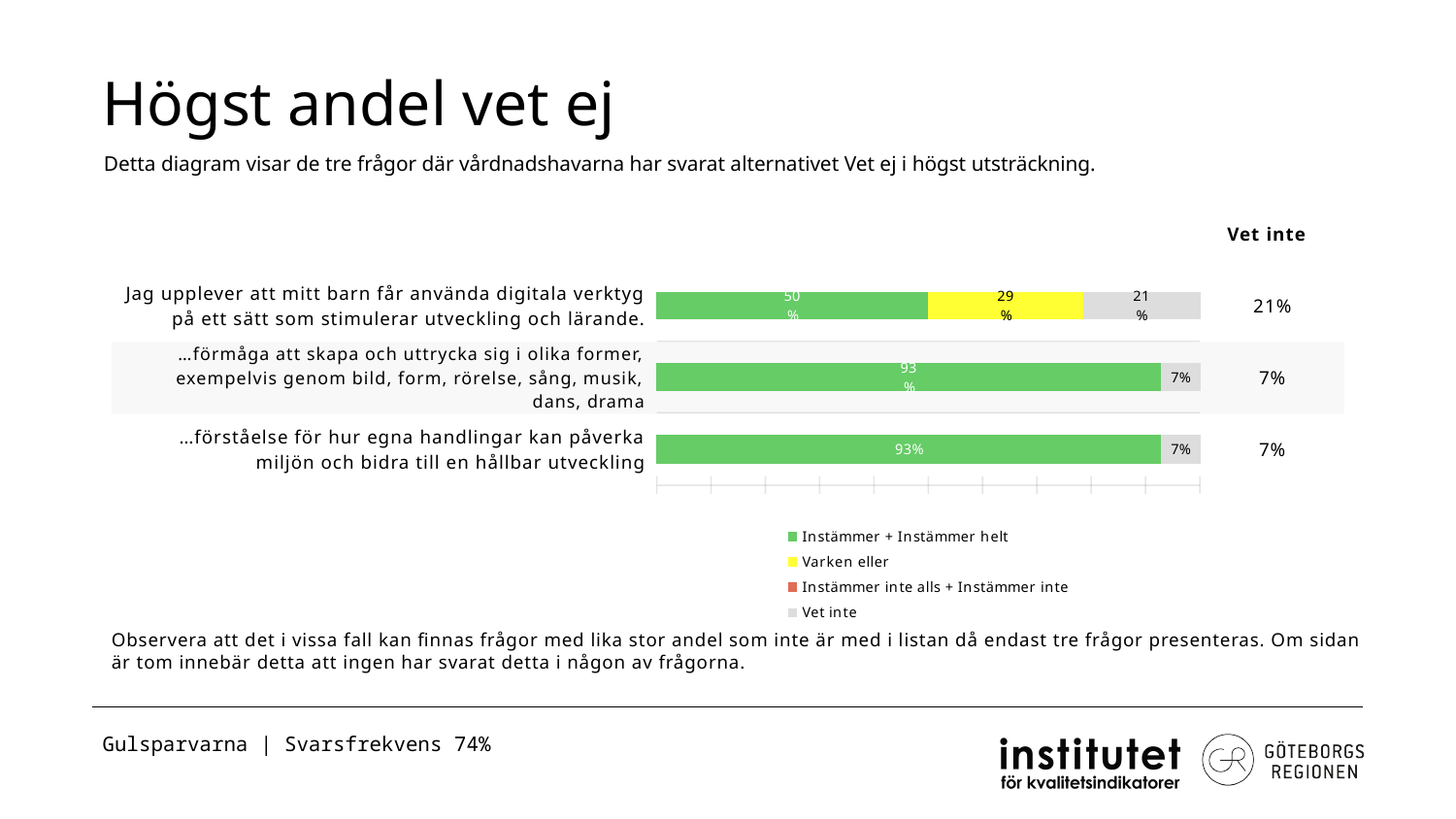
What is the difference between the 'Vet inte' value for the digital tools question (21%) and the 'Vet inte' value for the environment question (7%)? 14% Which is larger: the 'Instämmer + Instämmer helt' value for the digital tools question or for the environment question? the environment question What kind of chart is shown on the slide? stacked bar chart What is the 'Instämmer + Instämmer helt' value for 'Jag upplever att mitt barn får använda digitala verktyg på ett sätt som stimulerar utveckling och lärande'? 50% Which question has the highest 'Vet inte' share? Jag upplever att mitt barn får använda digitala verktyg på ett sätt som stimulerar utveckling och lärande What is the 'Vet inte' value for '…förmåga att skapa och uttrycka sig i olika former, exempelvis genom bild, form, rörelse, sång, musik, dans, drama'? 7% How many series does the legend list? 4 What is the 'Instämmer + Instämmer helt' value for '…förståelse för hur egna handlingar kan påverka miljön och bidra till en hållbar utveckling'? 93% How many questions (categories) are plotted in the chart? 3 What is the 'Varken eller' value for 'Jag upplever att mitt barn får använda digitala verktyg på ett sätt som stimulerar utveckling och lärande'? 29% What is the title of the slide containing the chart? Högst andel vet ej What is the 'Vet inte' value for 'Jag upplever att mitt barn får använda digitala verktyg på ett sätt som stimulerar utveckling och lärande'? 21%